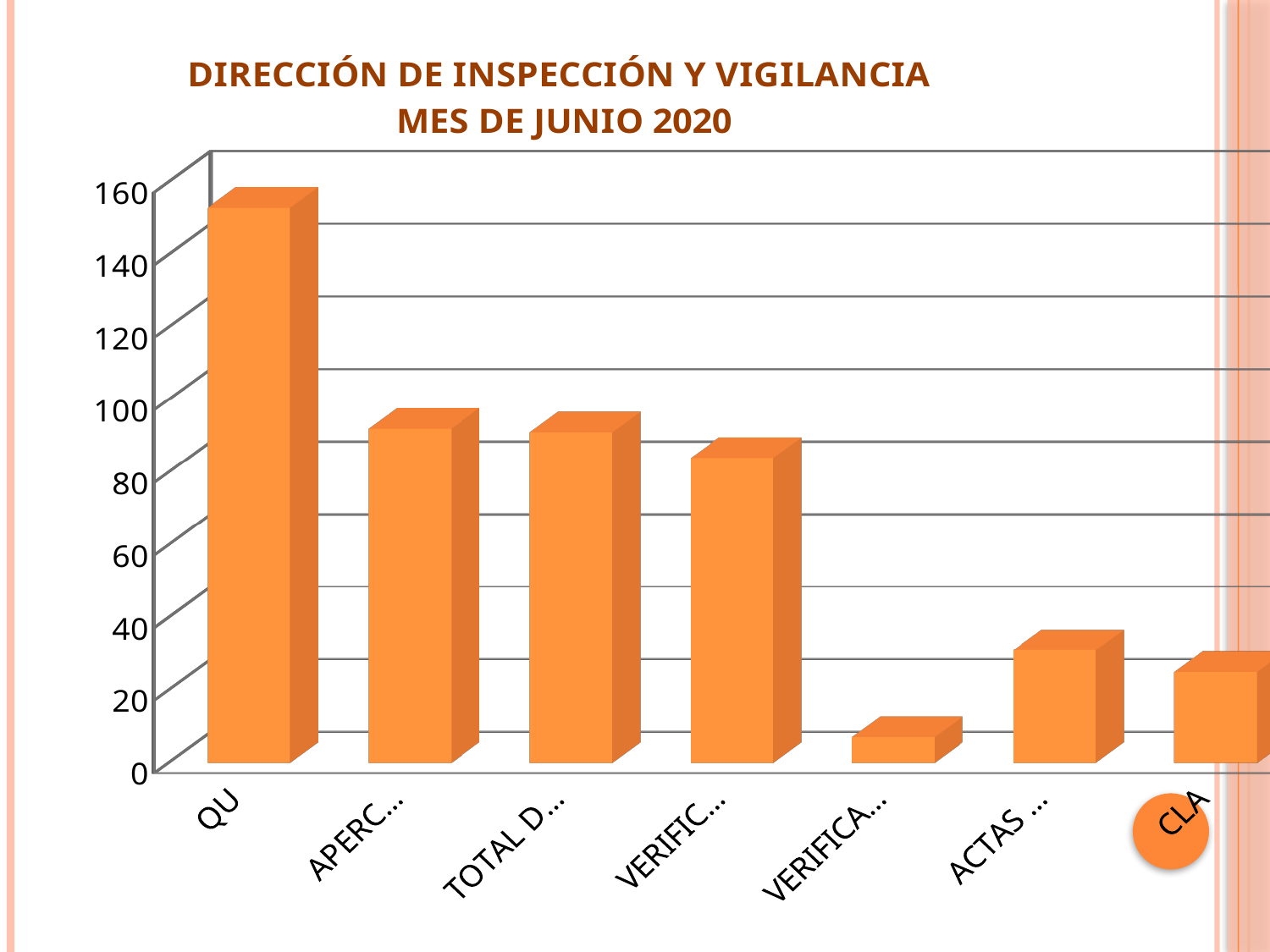
What kind of chart is shown on the slide? bar chart Is the value for the fourth bar (VERIFIC...) greater or less than 100? less Which category has the lowest bar? VERIFICA... (the fifth bar) Which is larger, the value for the first bar (QU) or the second bar (APERC...)? QU Is the value for the fifth bar (VERIFICA...) greater or less than 20? less What is the title of the chart? DIRECCIÓN DE INSPECCIÓN Y VIGILANCIA MES DE JUNIO 2020 Which category has the highest bar? QU (the first bar) Which is larger, the value for the sixth bar (ACTAS ...) or the fifth bar (VERIFICA...)? ACTAS ... Is the value for the first bar (QU) greater or less than 140? greater How many bars (categories) does the chart show? 7